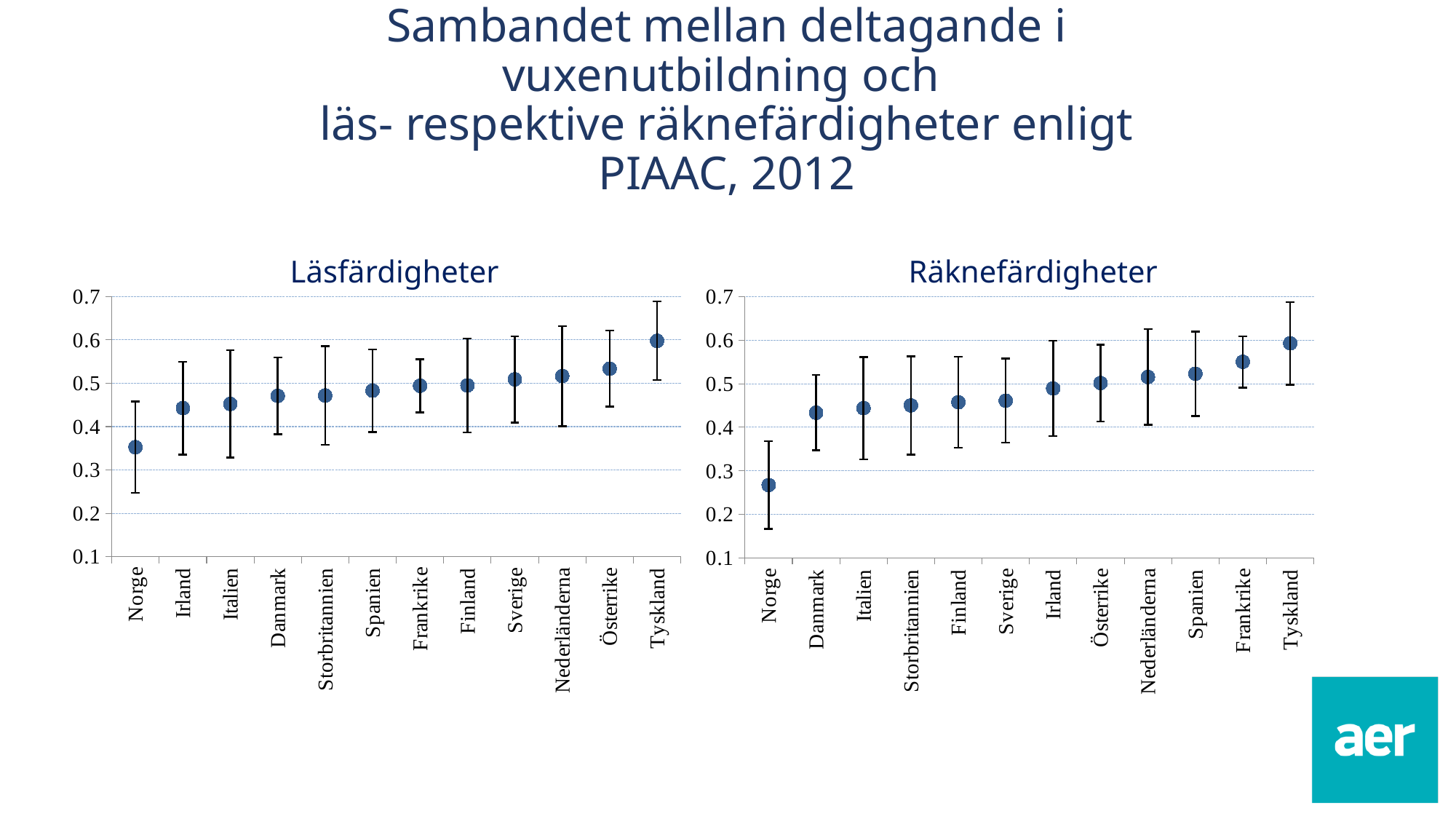
What kind of chart is the Räknefärdigheter chart? scatter chart with error bars In the Läsfärdigheter chart, is the value for Norge greater or less than 0.4? less In the Läsfärdigheter chart, do the plotted values rise or fall from left to right along the x axis? rise In the Läsfärdigheter chart, is the value for Irland greater or less than 0.5? less In the Läsfärdigheter chart, which country has the highest plotted value? Tyskland In the Räknefärdigheter chart, is the value for Norge greater or less than 0.3? less In the Läsfärdigheter chart, which country has the lowest plotted value? Norge In the Räknefärdigheter chart, which country has the highest plotted value? Tyskland In the Räknefärdigheter chart, which country has the lowest plotted value? Norge In the Räknefärdigheter chart, which has the larger value, Norge or Danmark? Danmark How many countries are plotted in the Läsfärdigheter chart? 12